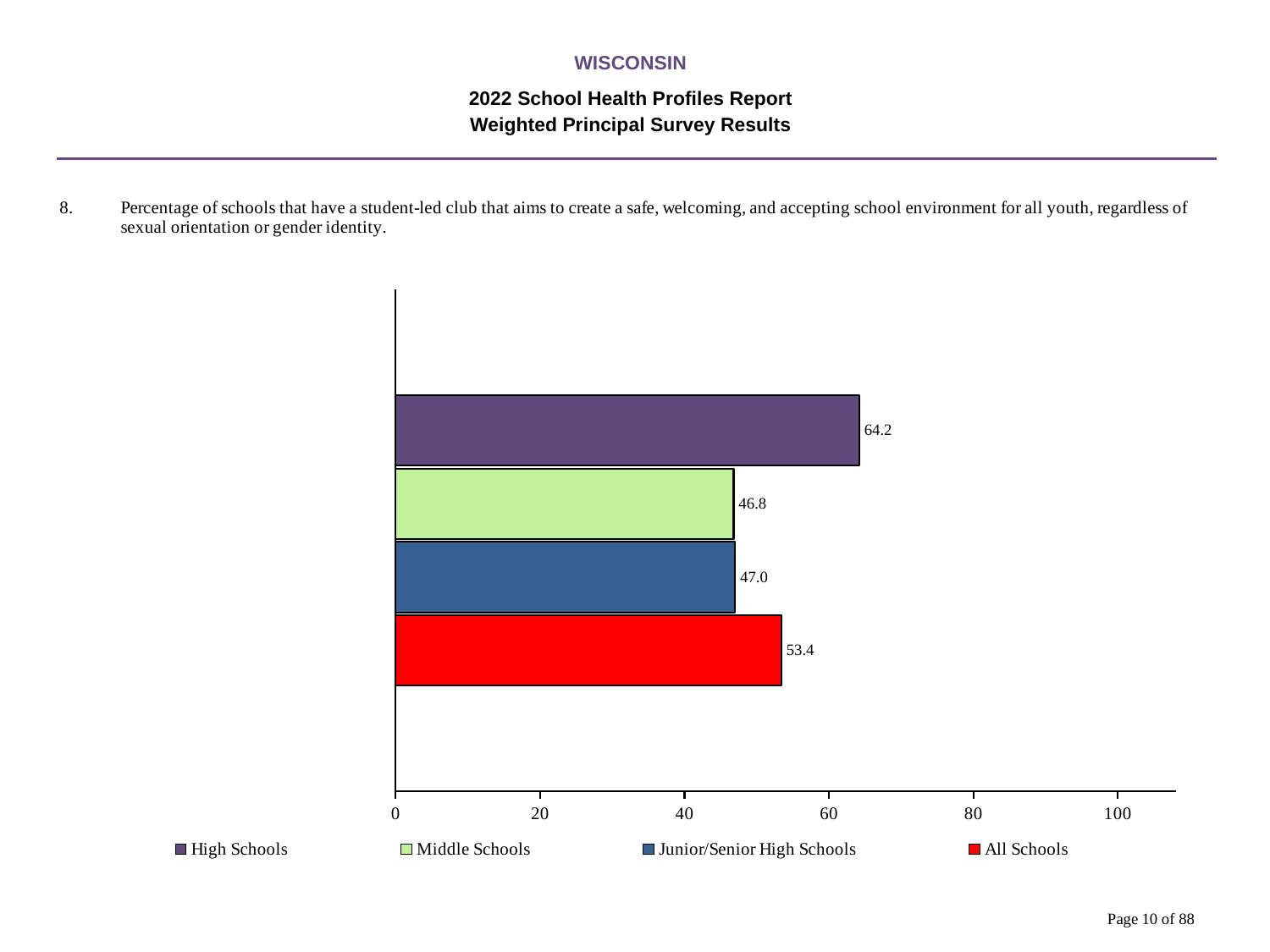
Which school type has the lowest value? Middle Schools Is the value for All Schools greater or less than 60? less What is the difference between the High Schools value and the All Schools value? 10.8 What kind of chart is shown on the slide? bar chart Which school type has the highest value? High Schools What is the value for Junior/Senior High Schools? 47.0 How many series does the legend list? 4 Which is larger, the value for High Schools or the value for All Schools? High Schools What is the value for All Schools? 53.4 What is the value for High Schools? 64.2 What is the difference between the Junior/Senior High Schools value and the Middle Schools value? 0.2 What is the value for Middle Schools? 46.8